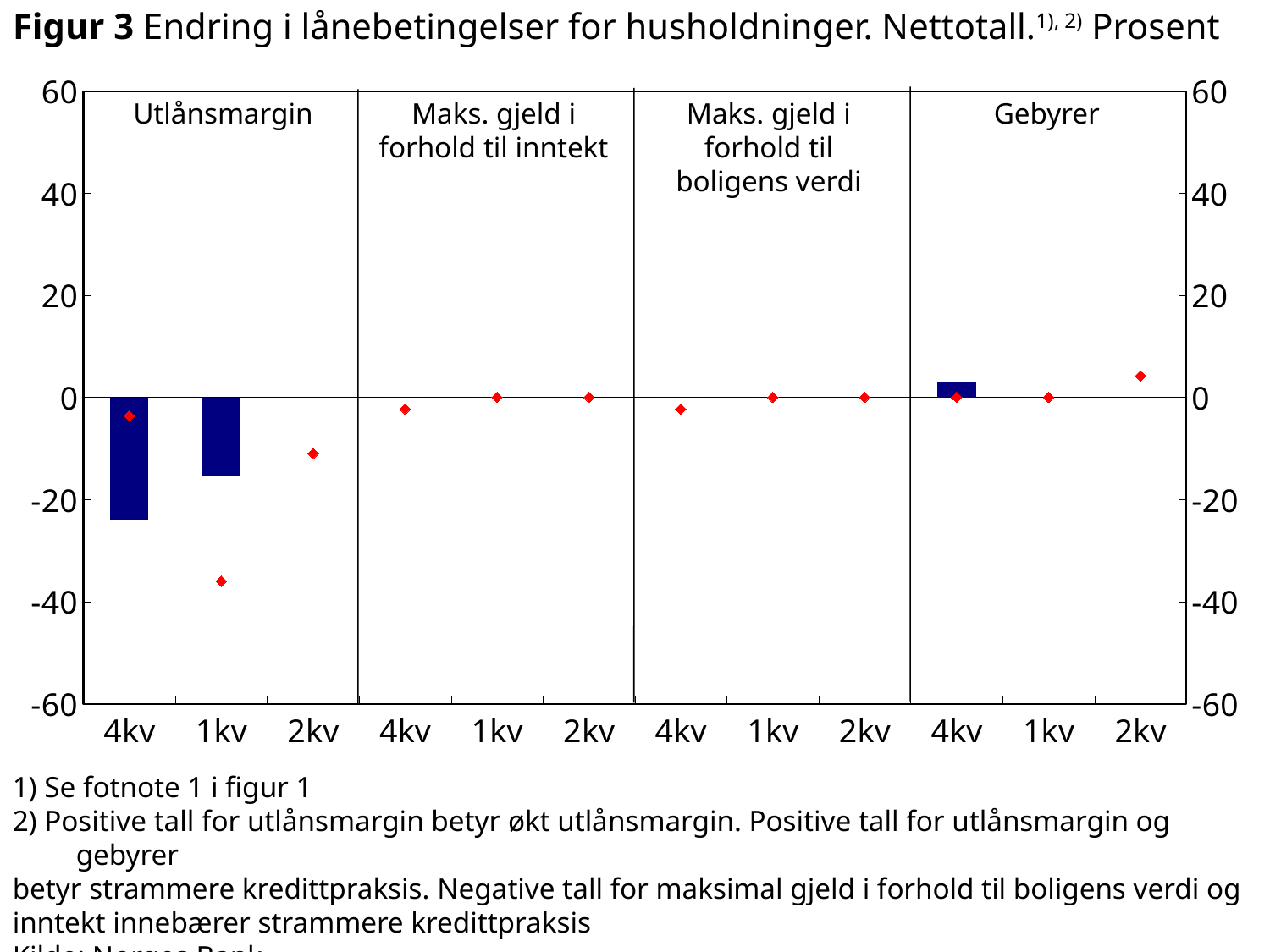
In which panel and quarter is the lowest red diamond marker on the chart? Utlånsmargin, 1kv Is the red diamond marker for 1kv in the Utlånsmargin panel greater or less than -40? greater In the Utlånsmargin panel, which quarter has the lower bar, 4kv or 1kv? 4kv Is the value of the Utlånsmargin bar for 1kv greater or less than -20? greater How many quarters are shown on the x axis within each panel? 3 Is the value of the Utlånsmargin bar for 4kv greater or less than -20? less Which panel contains a bar with a positive value? Gebyrer What kind of chart is shown on the slide? combination chart with bars and diamond markers How many panels (loan condition categories) does the chart have? 4 What are the minimum and maximum values shown on the vertical axis? -60 and 60 What is the title of the figure? Figur 3 Endring i lånebetingelser for husholdninger. Nettotall. Prosent